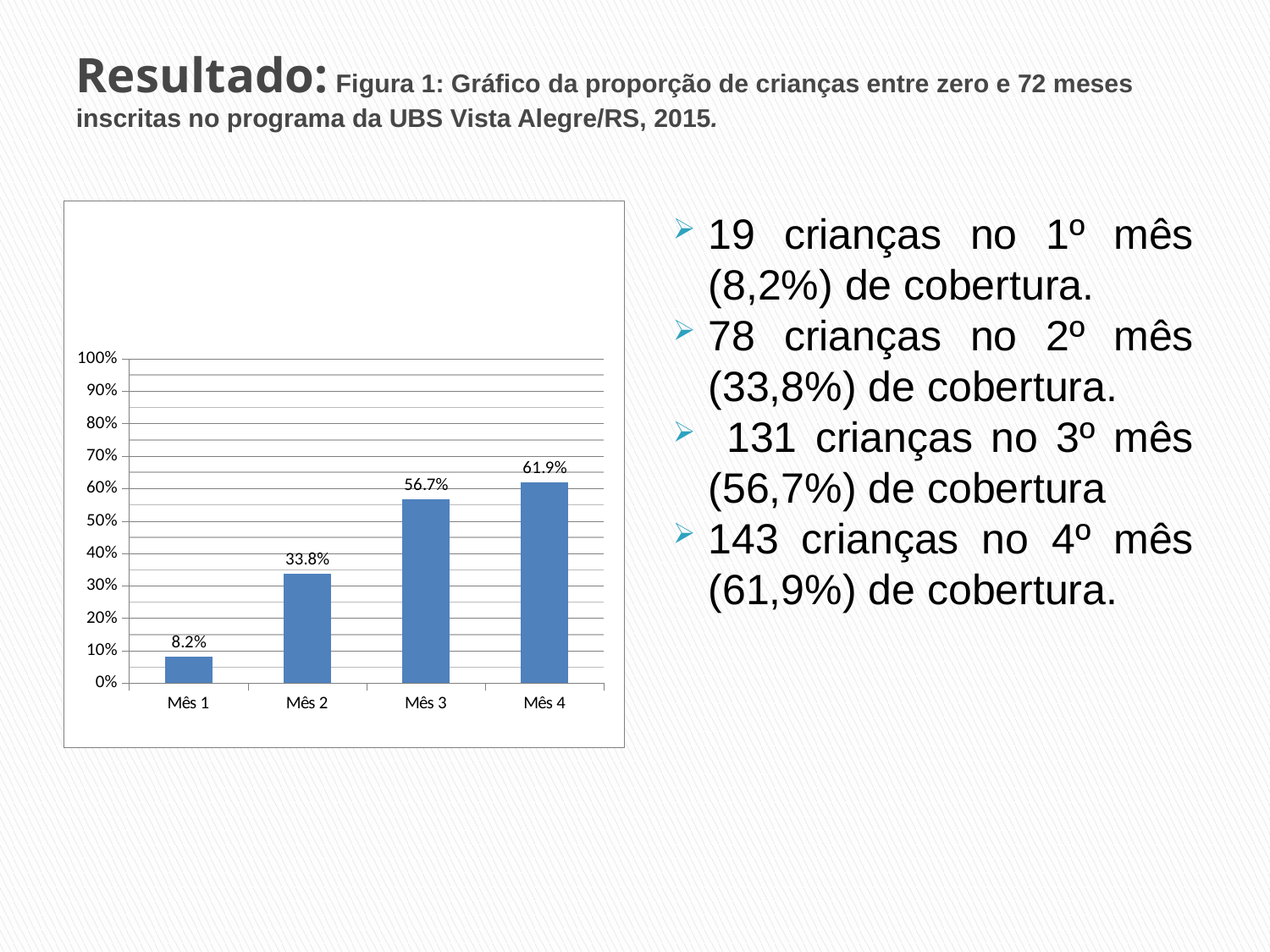
What is the value for Mês 1? 8.2% Which month has the lowest value? Mês 1 How many months are shown on the x axis? 4 What is the difference between the values for Mês 2 and Mês 1? 25.6% Which month has the highest value? Mês 4 What is the value for Mês 3? 56.7% Do the values rise or fall from Mês 1 to Mês 4? rise Is the value for Mês 2 greater or less than 40%? less What kind of chart is shown on the slide? bar chart What is the value for Mês 4? 61.9% Which is larger, the value for Mês 2 or the value for Mês 3? Mês 3 What is the difference between the values for Mês 4 and Mês 3? 5.2%